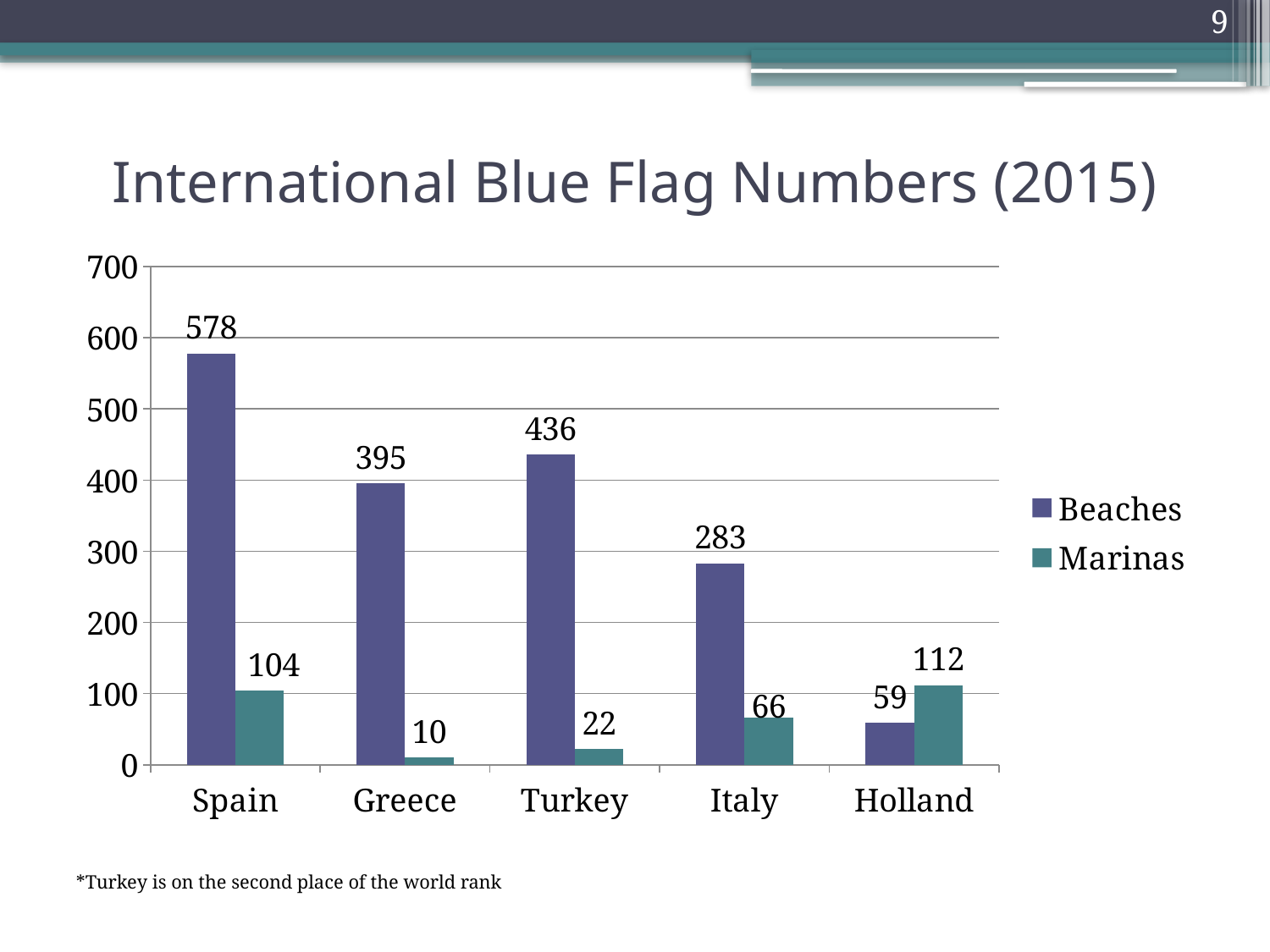
What is the Beaches value for Holland? 59 Which country has the lowest number of Blue Flag marinas? Greece What is the title of the chart? International Blue Flag Numbers (2015) How many countries are shown on the x axis? 5 What is the difference between the Beaches values for Turkey and Greece? 41 Which is larger, the Marinas value for Holland or the Marinas value for Spain? Holland Is the Beaches value for Italy greater or less than 300? less How many Blue Flag beaches does Spain have? 578 What is the Marinas value for Greece? 10 Which country has the highest number of Blue Flag beaches? Spain How many series does the legend list? 2 What kind of chart is shown on the slide? bar chart